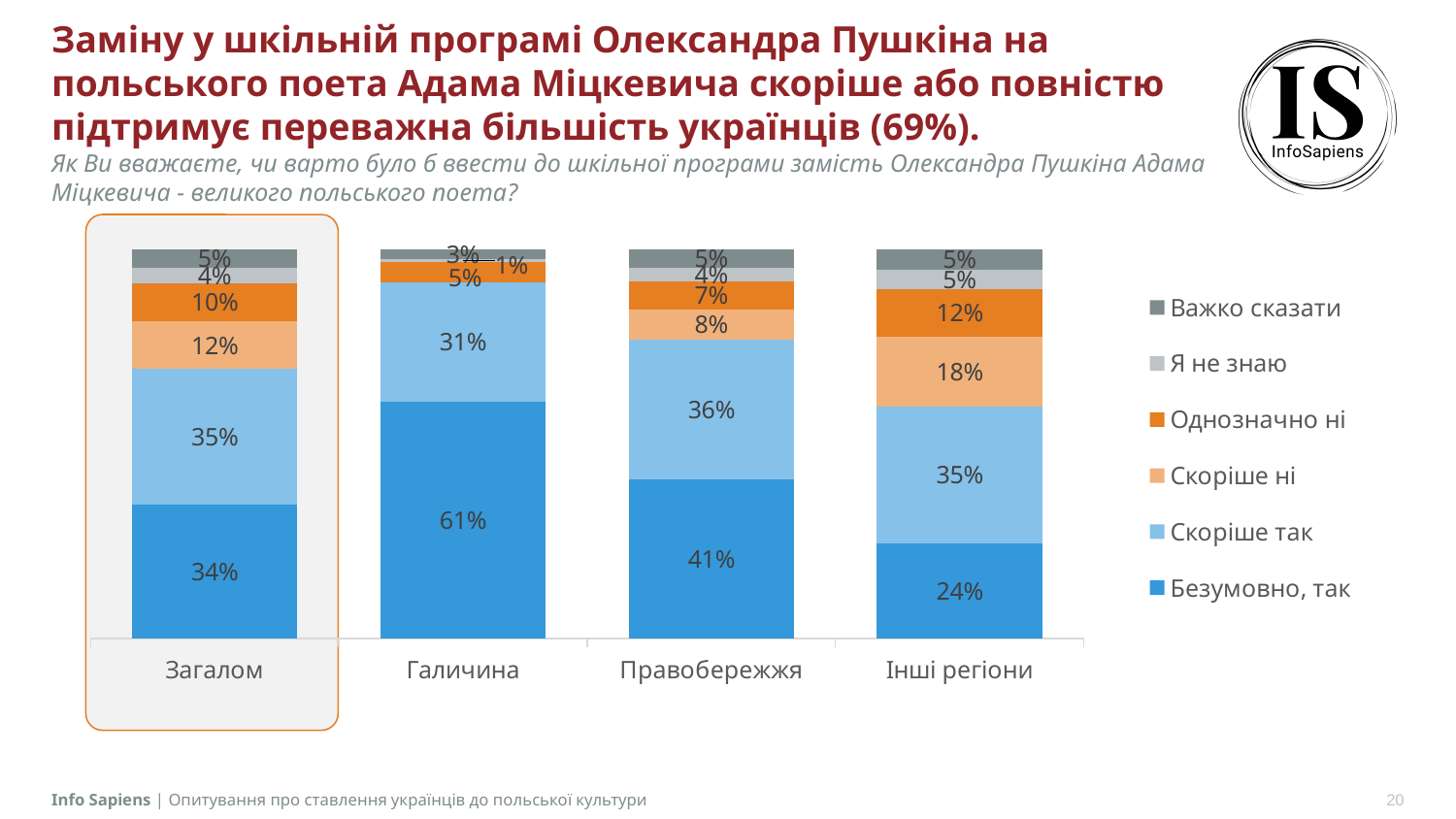
What is the value of 'Безумовно, так' for Галичина? 61% What is the value of 'Скоріше ні' for Інші регіони? 18% What is the difference between the 'Безумовно, так' values for Галичина and Інші регіони? 37% What type of chart is shown on the slide? Stacked bar chart How many categories are shown on the x axis? 4 Which category is highlighted with an orange outline on the slide? Загалом What is the value of 'Однозначно ні' for Загалом? 10% Which category has the highest value for 'Безумовно, так'? Галичина What is the value of 'Скоріше так' for Правобережжя? 36% Which category has the lowest value for 'Безумовно, так'? Інші регіони How many series does the legend list? 6 Which is larger: 'Скоріше ні' for Інші регіони or 'Скоріше ні' for Правобережжя? Інші регіони